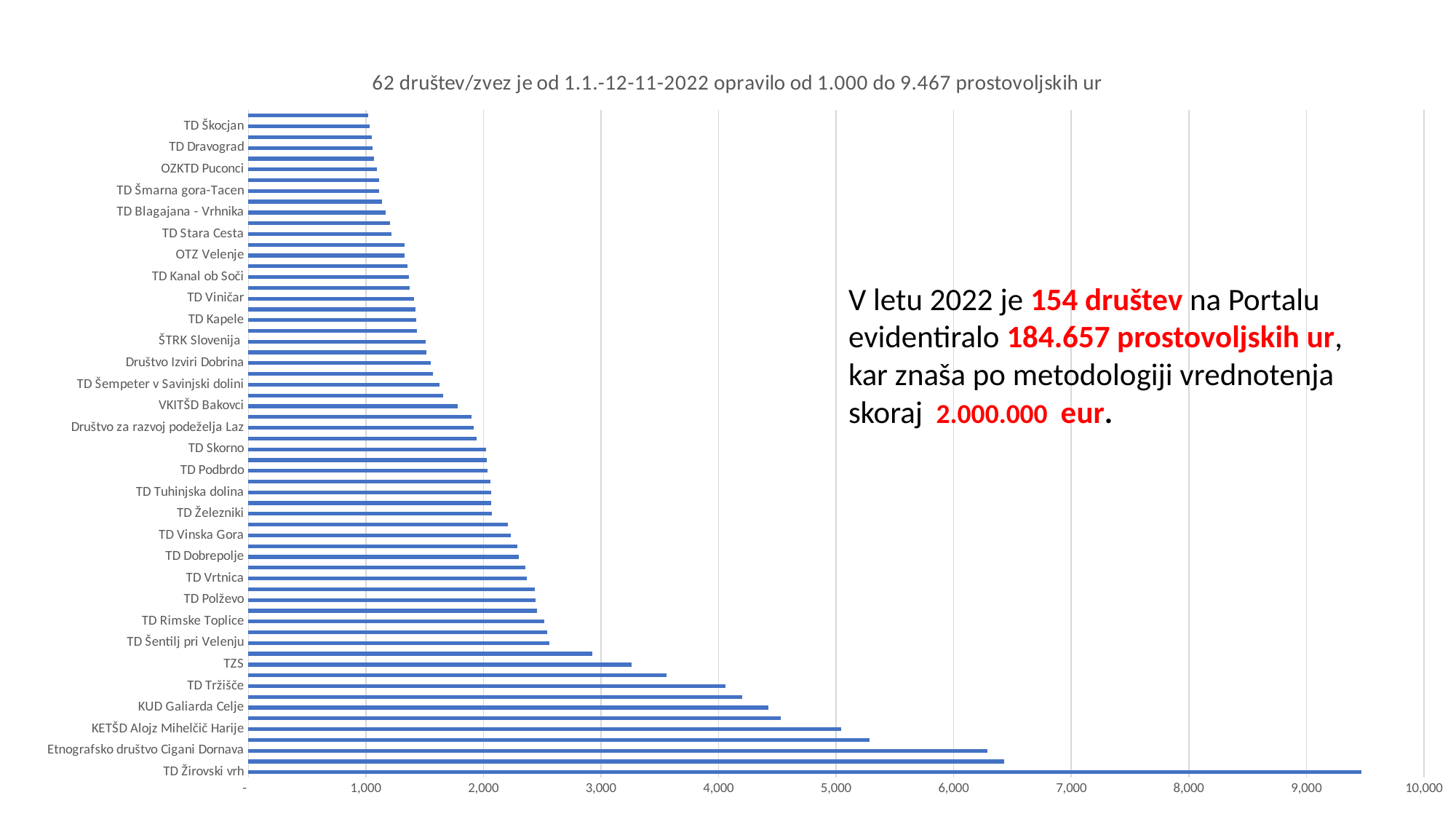
Which has a larger value, TD Žirovski vrh or TD Škocjan? TD Žirovski vrh Is the value for TD Šentilj pri Velenju greater or less than 3,000? less Is the value for TD Tržišče greater or less than 3,000? greater According to the chart title, how many društev/zvez are represented in the chart? 62 What is the highest value shown on the horizontal axis of the chart? 10,000 Is the value for TD Žirovski vrh greater or less than 9,000? greater What kind of chart is shown on the slide? bar chart Which category has the longest bar in the chart? TD Žirovski vrh